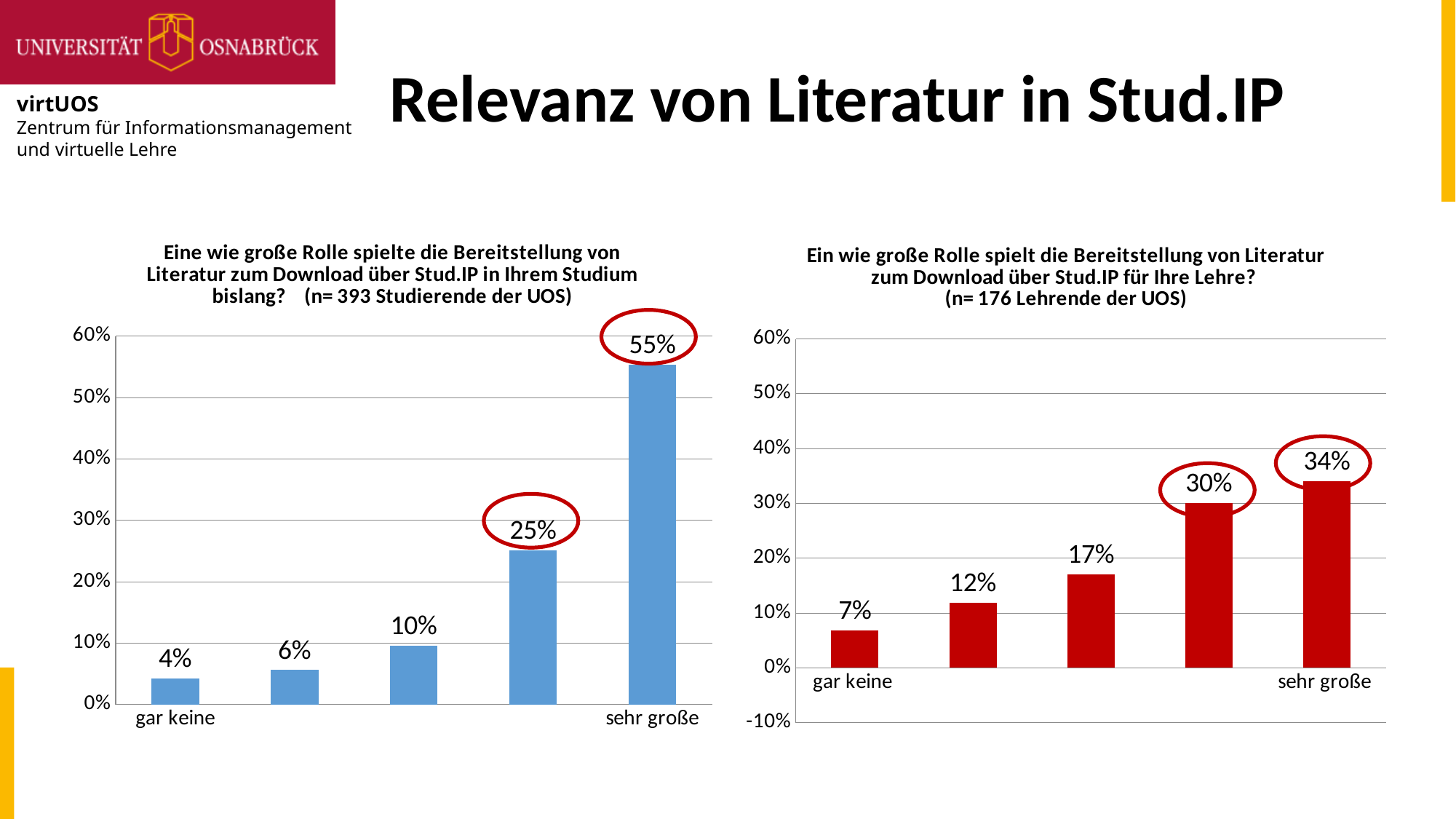
In the right chart (teachers, n= 176), do the values rise or fall from "gar keine" to "sehr große"? rise In the left chart (students, n= 393), what is the difference between the values for "sehr große" and "gar keine"? 51% In the left chart (students, n= 393), what is the value for "gar keine"? 4% In the right chart (teachers, n= 176), what is the value for "gar keine"? 7% In the right chart (teachers, n= 176), which category has the lowest value? gar keine In the left chart (students, n= 393), which category has the highest value? sehr große In the right chart (teachers, n= 176), what is the value for "sehr große"? 34% What kind of chart is the left chart (students, n= 393)? bar chart In the right chart (teachers, n= 176), what is the difference between the values for "sehr große" and "gar keine"? 27% Which is larger: the value for "sehr große" in the left chart (students) or in the right chart (teachers)? left chart (students), 55% In the left chart (students, n= 393), what is the value for "sehr große"? 55% How many bars does the right chart (teachers, n= 176) have? 5